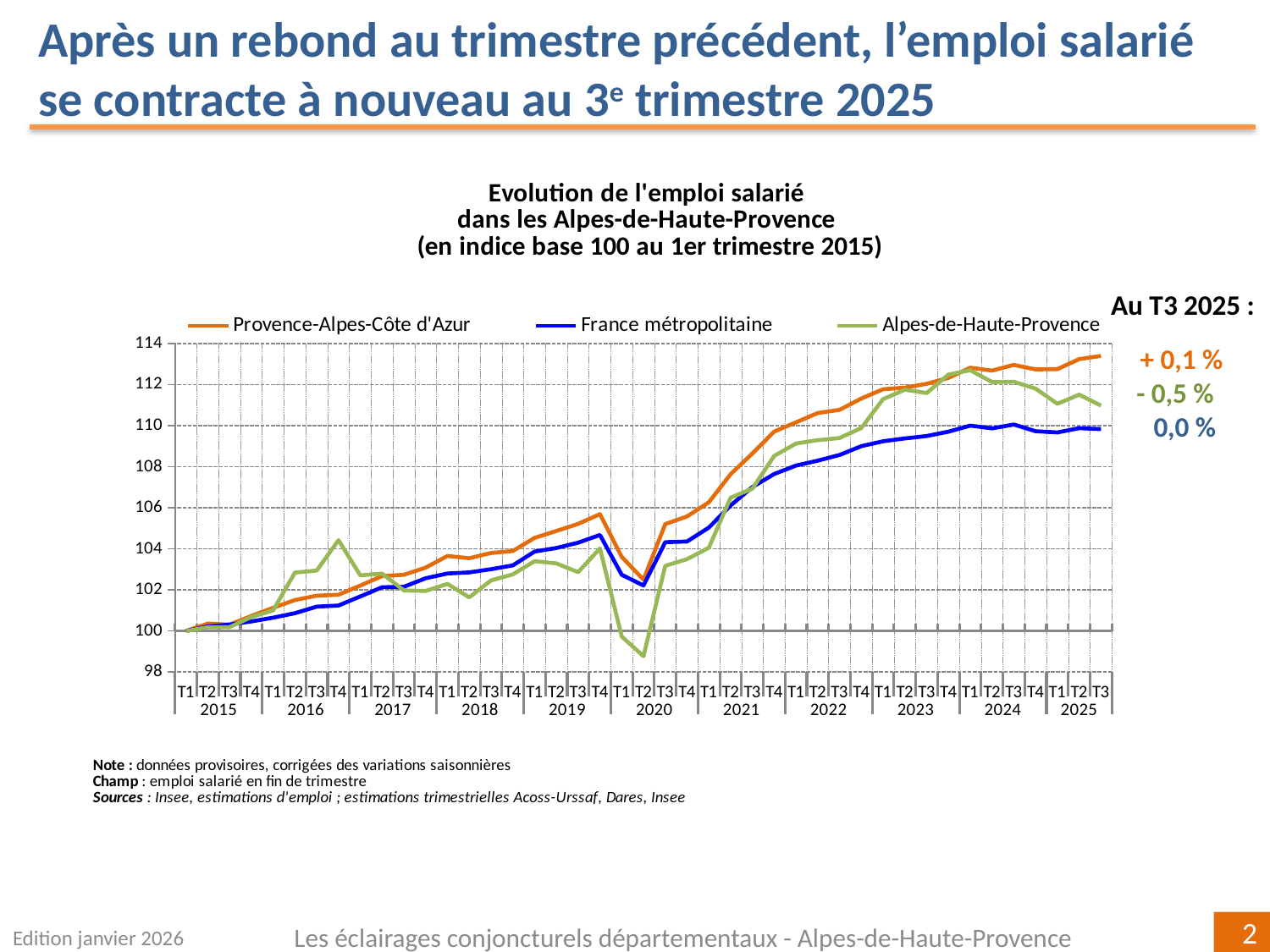
Is the value for Provence-Alpes-Côte d'Azur at T3 2025 greater or less than 112? greater How many years are labelled on the x axis? 11 Which series has the highest value at T3 2025? Provence-Alpes-Côte d'Azur Is the value for France métropolitaine at T3 2025 greater or less than 112? less Which three series are listed in the legend? Provence-Alpes-Côte d'Azur, France métropolitaine, Alpes-de-Haute-Provence What is the index value of all three series at T1 2015? 100 At T3 2025, which series is higher: Provence-Alpes-Côte d'Azur or France métropolitaine? Provence-Alpes-Côte d'Azur Does the France métropolitaine series rise or fall between T1 2021 and T1 2024? rise What type of chart is shown on the slide? line chart How many series does the legend list? 3 Which series has the lowest value at T2 2020? Alpes-de-Haute-Provence Is the value for Alpes-de-Haute-Provence at T2 2020 greater or less than 100? less